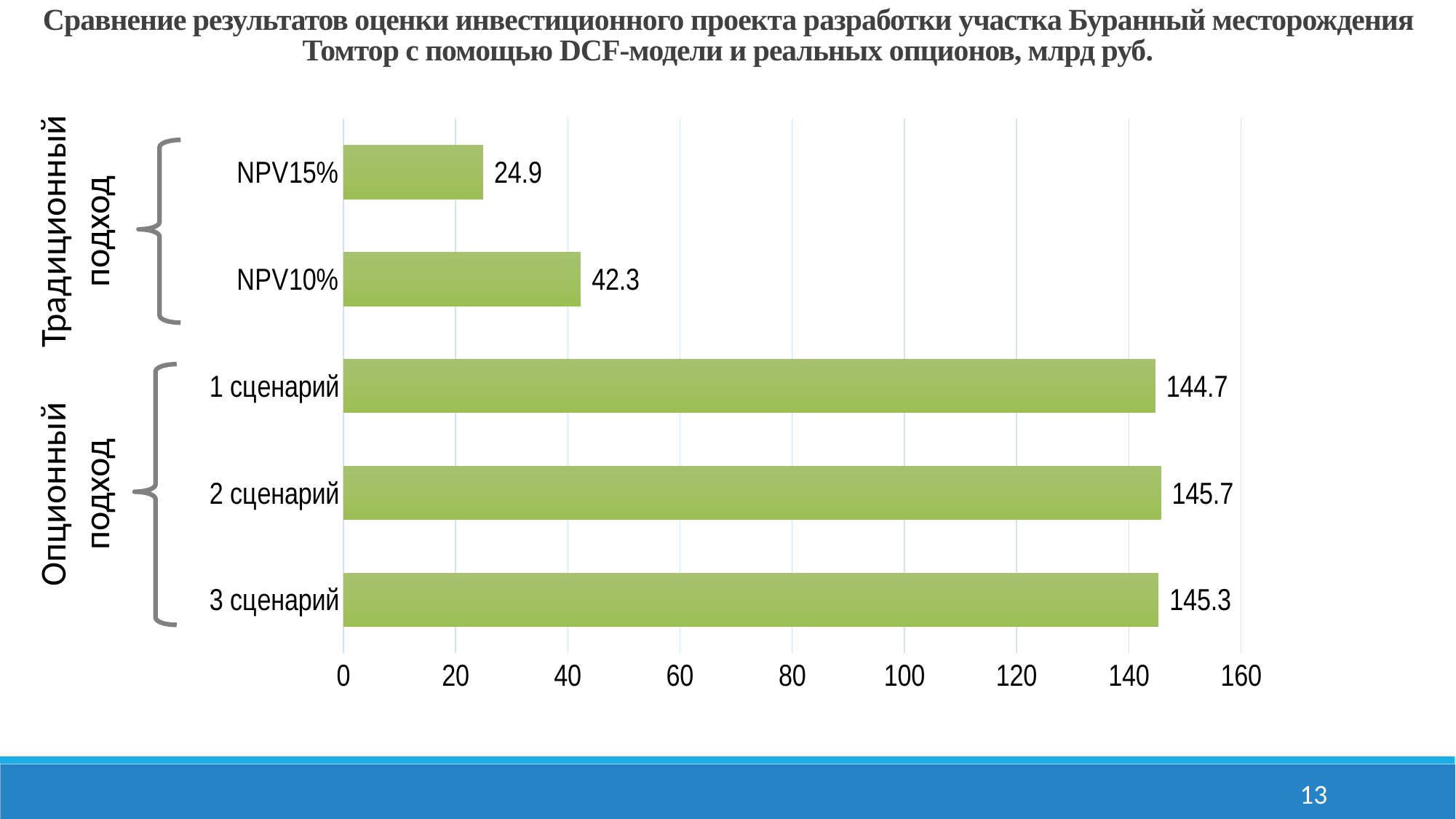
Which is larger, the value for NPV10% or the value for 1 сценарий? 1 сценарий What is the value for 3 сценарий? 145.3 Which category has the lowest value? NPV15% What is the value for 2 сценарий? 145.7 What is the value for NPV15%? 24.9 What is the value for 1 сценарий? 144.7 What kind of chart is shown on the slide? Bar chart How many categories are shown in the chart? 5 What is the difference between the values for 2 сценарий and 1 сценарий? 1.0 What is the difference between the values for NPV10% and NPV15%? 17.4 What is the value for NPV10%? 42.3 Which category has the highest value? 2 сценарий